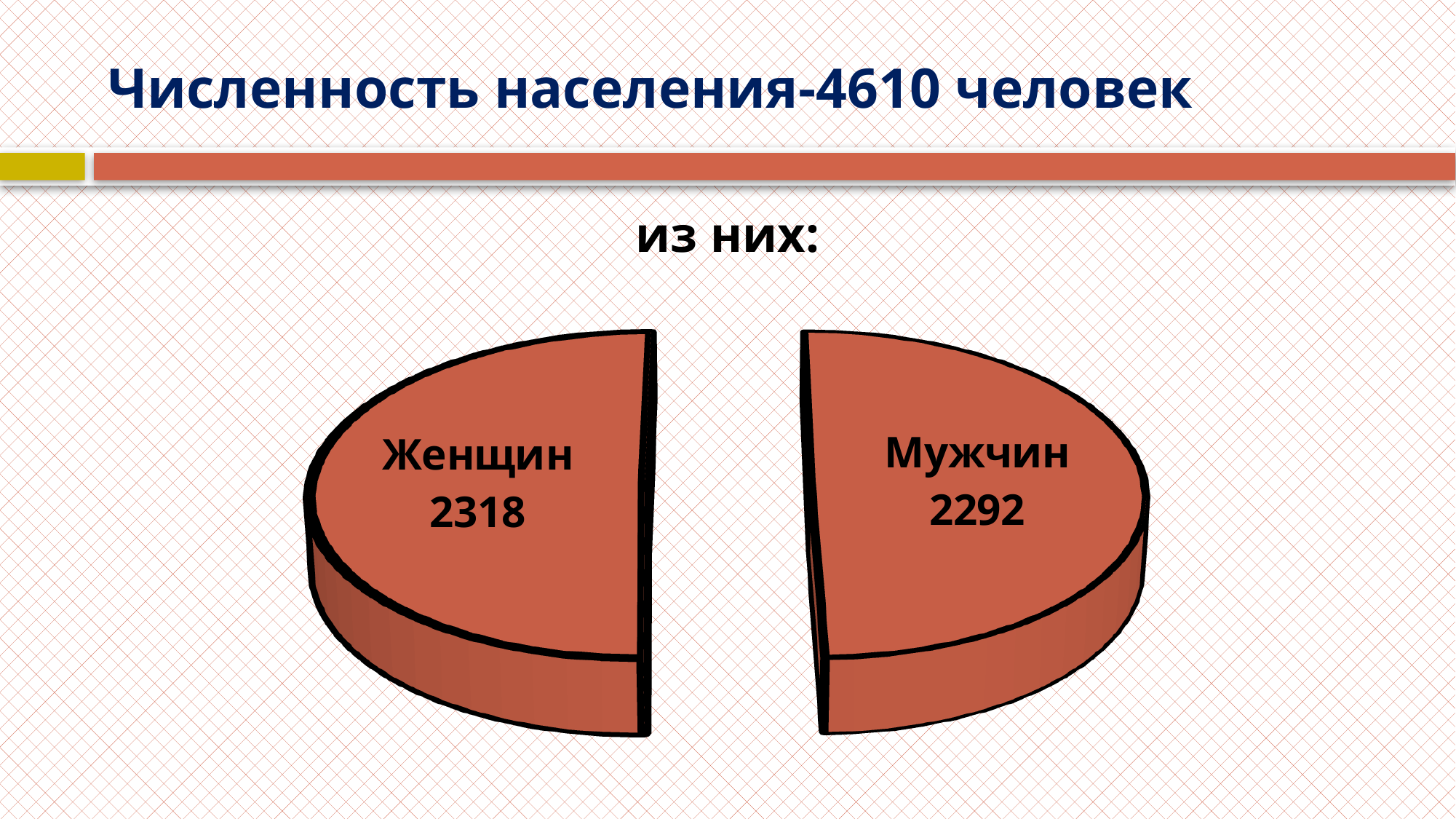
What is the value shown for Женщин on the pie chart? 2318 Which slice of the pie chart has the larger value? Женщин Is the value for Женщин larger or smaller than the value for Мужчин? larger What is the value shown for Мужчин on the pie chart? 2292 What text appears directly above the pie chart? из них: What is the title of the slide containing the pie chart? Численность населения-4610 человек Which slice of the pie chart has the smaller value? Мужчин What is the total of the two values shown on the pie chart? 4610 How many slices does the pie chart have? 2 What is the difference between the values for Женщин and Мужчин? 26 What kind of chart is shown on the slide? pie chart